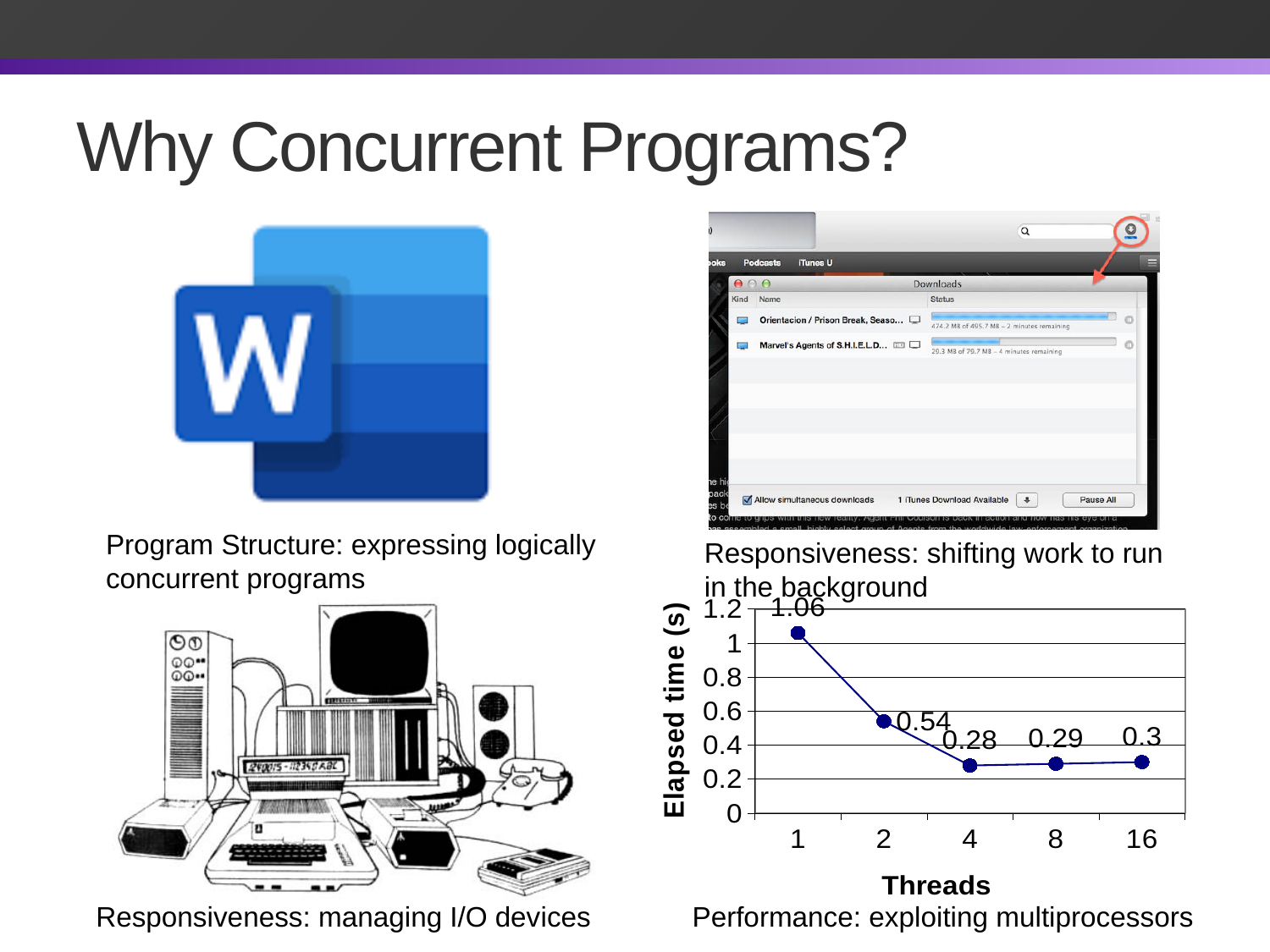
What is the elapsed time for 16 threads? 0.3 What is the elapsed time for 4 threads? 0.28 What kind of chart is used to show elapsed time against threads? Line chart How many thread counts are plotted on the x axis? 5 Does the elapsed time generally rise or fall as the number of threads increases from 1 to 4? Fall What is the difference in elapsed time between 1 thread and 2 threads? 0.52 Which thread count has the highest elapsed time? 1 Which has a larger elapsed time, 2 threads or 8 threads? 2 threads What is the elapsed time for 1 thread? 1.06 What is the elapsed time for 2 threads? 0.54 What is the label of the y axis of the chart? Elapsed time (s) Which thread count has the lowest elapsed time? 4